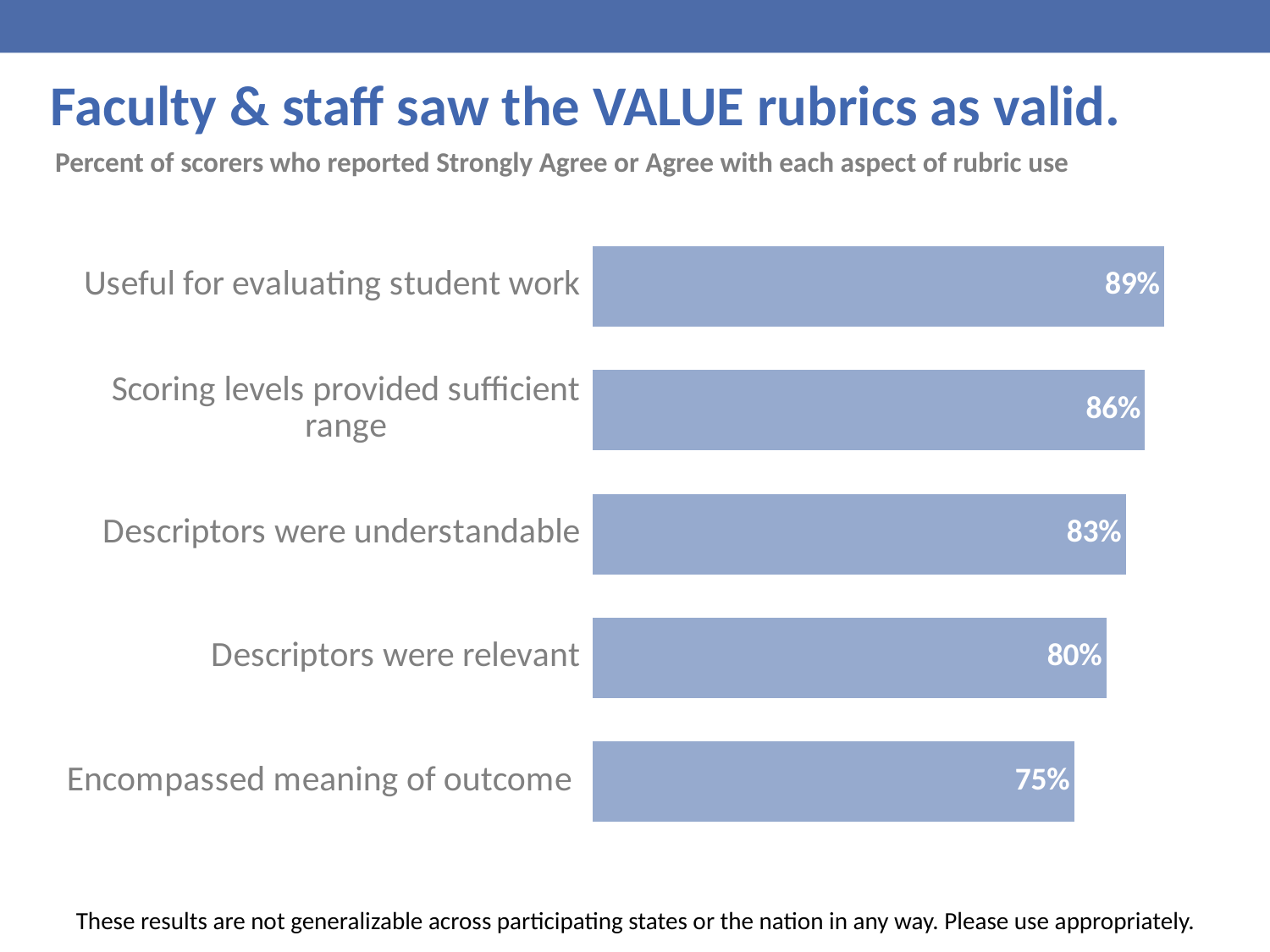
What kind of chart is shown on the slide? Bar chart What is the difference between the values for 'Useful for evaluating student work' and 'Encompassed meaning of outcome'? 14% What percent of scorers agreed that the rubrics were useful for evaluating student work? 89% What is the difference between the values for 'Descriptors were understandable' and 'Descriptors were relevant'? 3% What is the value for 'Scoring levels provided sufficient range'? 86% Which aspect of rubric use has the lowest percentage of agreement? Encompassed meaning of outcome Which aspect of rubric use has the highest percentage of agreement? Useful for evaluating student work What is the value for 'Encompassed meaning of outcome'? 75% How many aspects of rubric use are shown in the chart? 5 What is the value for 'Descriptors were understandable'? 83% Which has a larger value: 'Scoring levels provided sufficient range' or 'Descriptors were relevant'? Scoring levels provided sufficient range What is the title of the slide containing the chart? Faculty & staff saw the VALUE rubrics as valid.